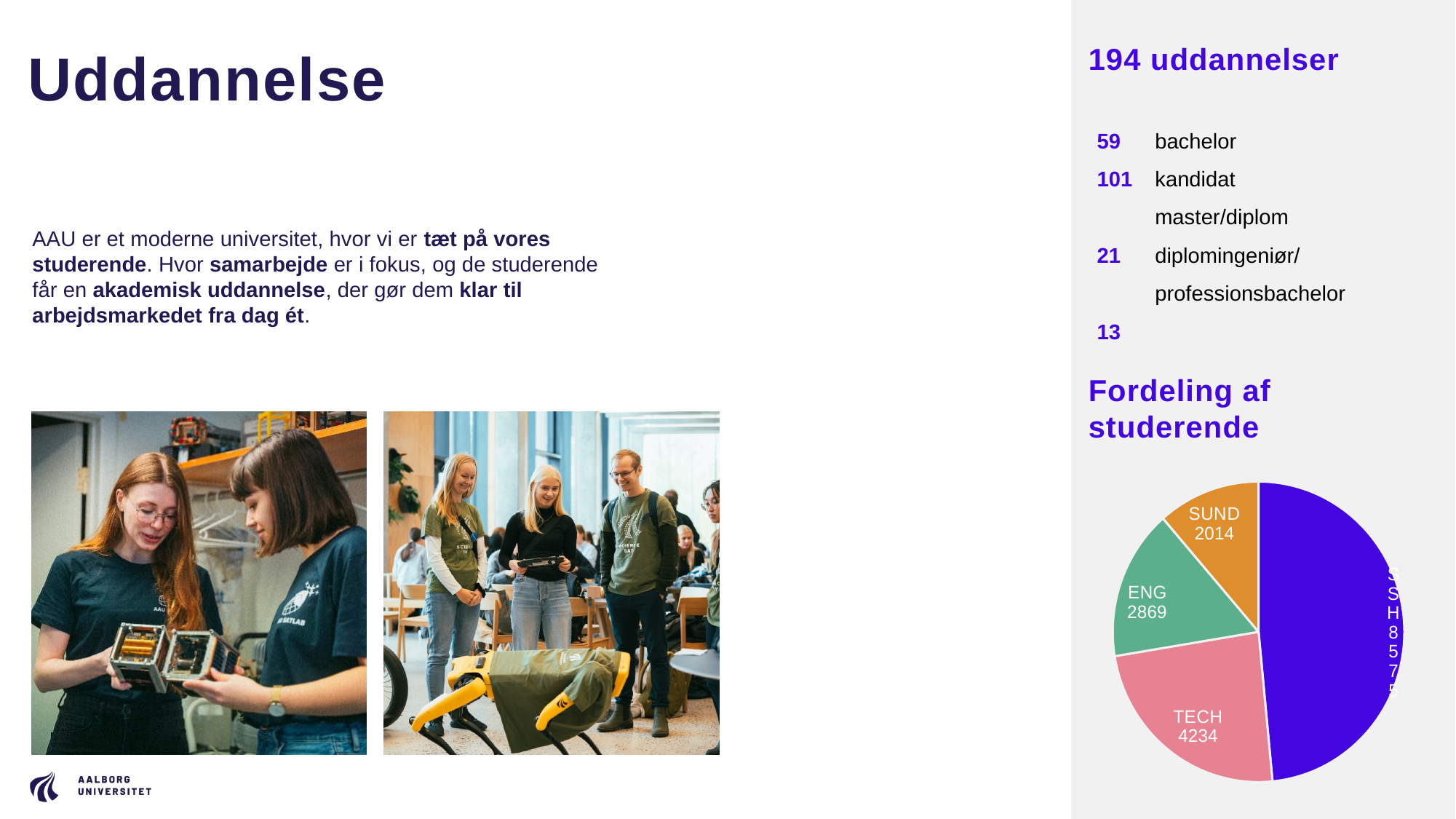
What is the value for SUND in the 'Fordeling af studerende' pie chart? 2014 Which category has the largest slice in the 'Fordeling af studerende' pie chart? SSH Which category has the smallest slice in the 'Fordeling af studerende' pie chart? SUND How many slices does the 'Fordeling af studerende' pie chart have? 4 What is the value for ENG in the 'Fordeling af studerende' pie chart? 2869 In the 'Fordeling af studerende' pie chart, what is the difference between ENG and SUND? 855 What is the value for TECH in the 'Fordeling af studerende' pie chart? 4234 In the 'Fordeling af studerende' pie chart, what is the difference between TECH and ENG? 1365 In the 'Fordeling af studerende' pie chart, which is larger, SUND or ENG? ENG What is the title of the pie chart on the slide? Fordeling af studerende In the 'Fordeling af studerende' pie chart, which is larger, TECH or ENG? TECH What kind of chart is shown under 'Fordeling af studerende'? pie chart